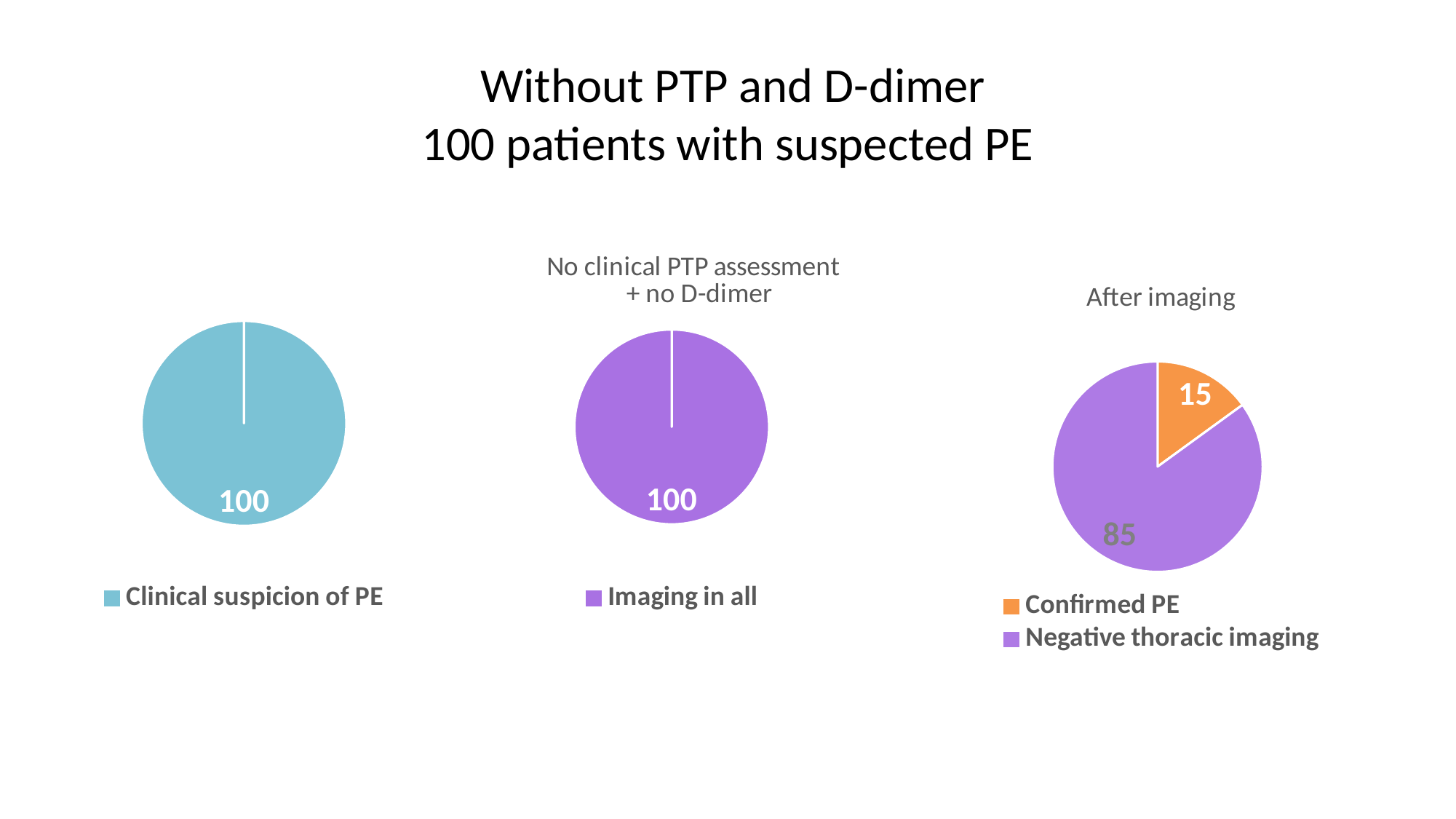
In the leftmost chart, what is the value for Clinical suspicion of PE? 100 In the 'After imaging' chart, which category has the largest slice? Negative thoracic imaging In the 'After imaging' chart, what is the value for Confirmed PE? 15 In the 'After imaging' chart, what colour is the Confirmed PE slice? Orange How many categories does the legend of the 'After imaging' chart list? 2 In the 'No clinical PTP assessment + no D-dimer' chart, what is the value for Imaging in all? 100 In the 'After imaging' chart, what is the difference between Negative thoracic imaging and Confirmed PE? 70 In the 'After imaging' chart, what is the value for Negative thoracic imaging? 85 In the 'After imaging' chart, which category has the smallest slice? Confirmed PE In the 'After imaging' chart, which is larger: Confirmed PE or Negative thoracic imaging? Negative thoracic imaging What kind of chart is the leftmost chart on the slide? Pie chart In the 'After imaging' chart, what share of the pie does Confirmed PE represent? 15%